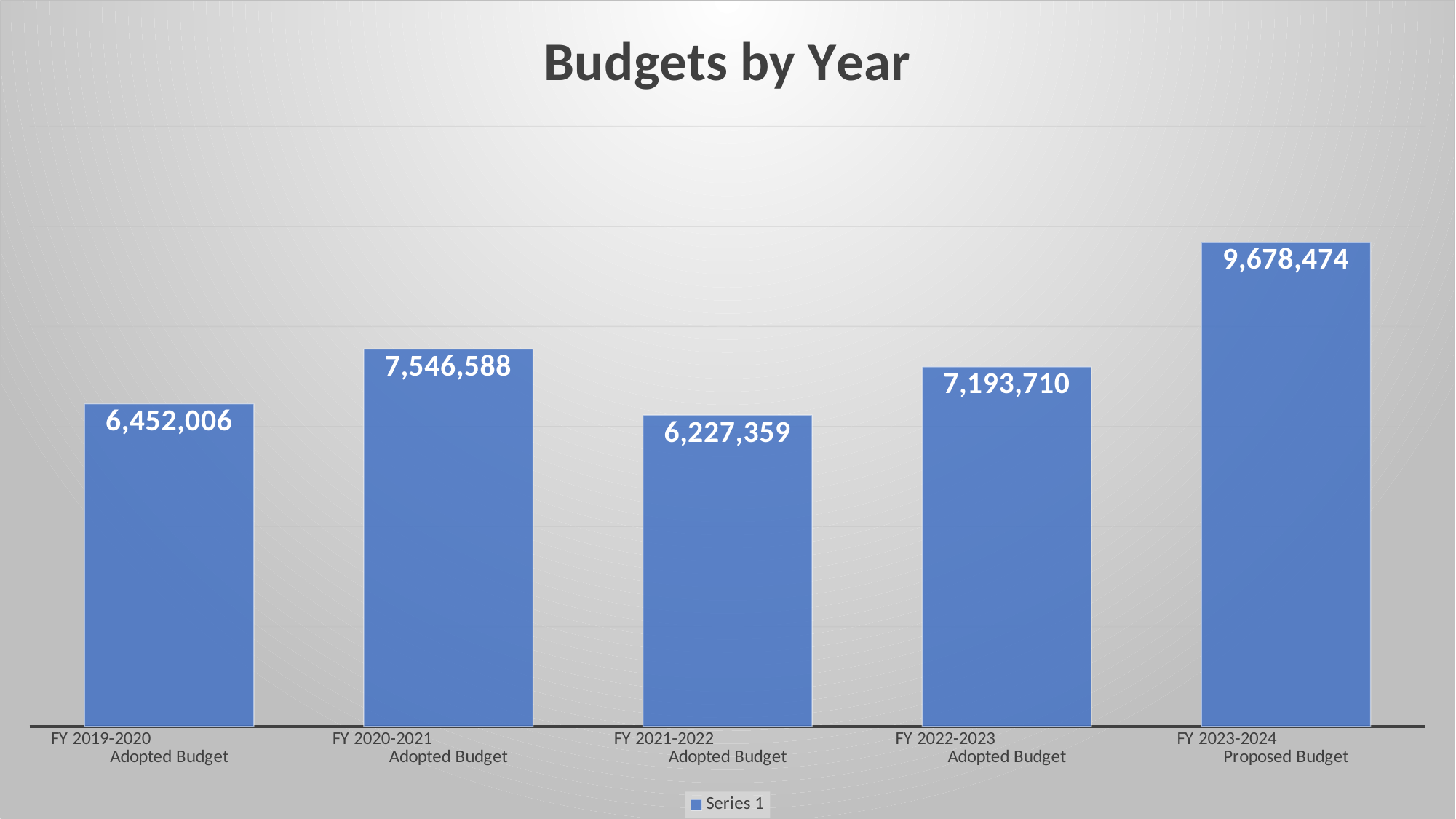
How many series does the legend list? 1 What is the difference between the FY 2023-2024 Proposed Budget and the FY 2022-2023 Adopted Budget? 2,484,764 What is the value for FY 2021-2022 Adopted Budget? 6,227,359 What is the value for FY 2019-2020 Adopted Budget? 6,452,006 Which category has the lowest value? FY 2021-2022 Adopted Budget Which is larger, the FY 2020-2021 Adopted Budget or the FY 2022-2023 Adopted Budget? FY 2020-2021 Adopted Budget What is the difference between the FY 2020-2021 Adopted Budget and the FY 2019-2020 Adopted Budget? 1,094,582 What is the title of the chart? Budgets by Year What kind of chart is shown? Bar chart Which category has the highest value? FY 2023-2024 Proposed Budget How many categories are shown on the chart? 5 What is the value for FY 2023-2024 Proposed Budget? 9,678,474